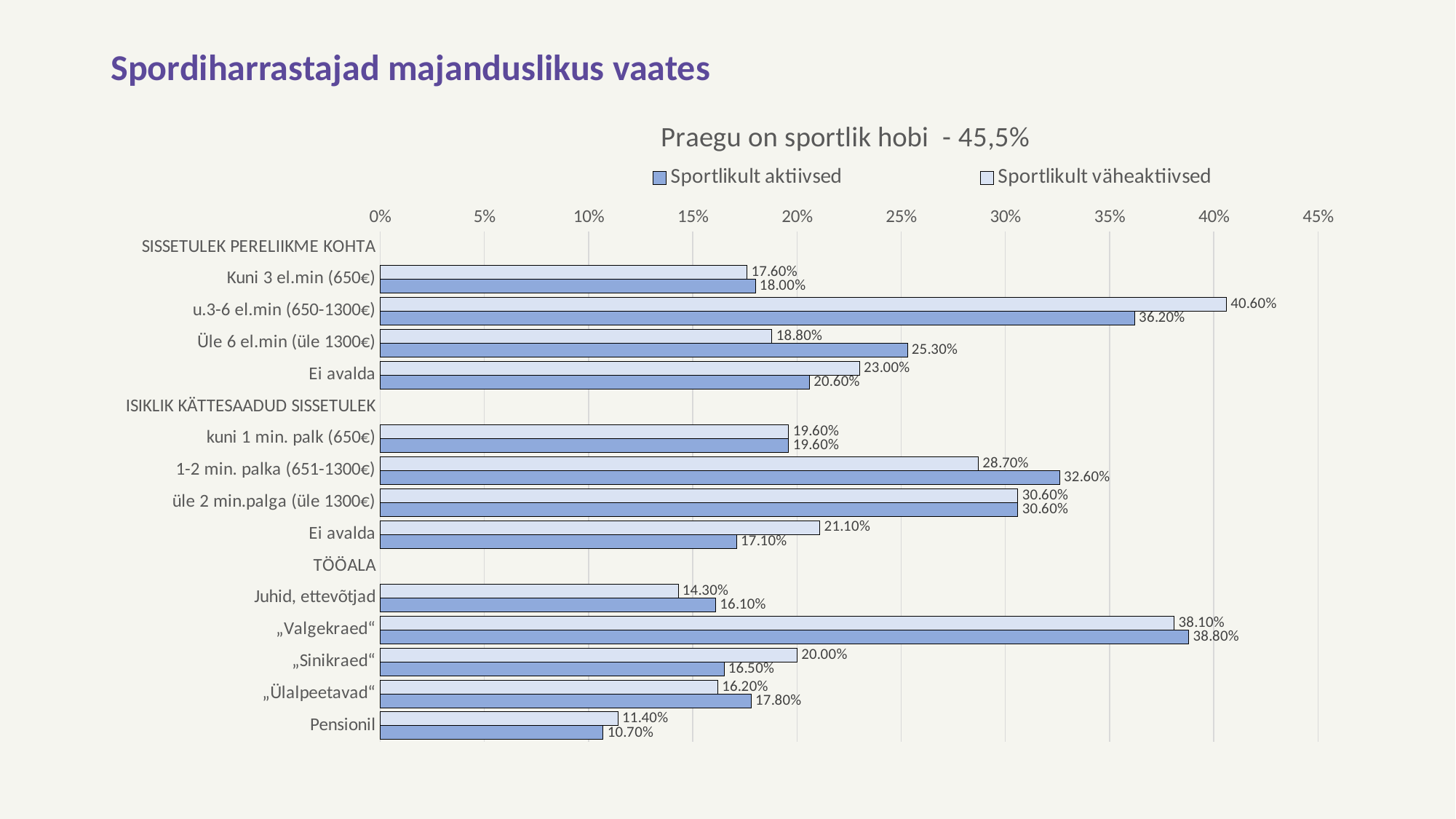
What kind of chart is shown on the slide? bar chart Is the "Sportlikult aktiivsed" value for 1-2 min. palka (651-1300€) greater or less than 30%? greater What is the value for "Sportlikult väheaktiivsed" in the category „Valgekraed“? 38.10% What is the value for "Sportlikult aktiivsed" in the category Pensionil? 10.70% What is the difference between the "Sportlikult aktiivsed" and "Sportlikult väheaktiivsed" values for Üle 6 el.min (üle 1300€)? 6.50% Which category has the lowest value for "Sportlikult aktiivsed"? Pensionil How many series does the legend list? 2 What is the value for "Sportlikult väheaktiivsed" in the "Ei avalda" category under ISIKLIK KÄTTESAADUD SISSETULEK? 21.10% Which category has the highest value for "Sportlikult väheaktiivsed"? u.3-6 el.min (650-1300€) What percentage is stated in the chart title next to "Praegu on sportlik hobi"? 45,5% What is the value for "Sportlikult aktiivsed" in the category u.3-6 el.min (650-1300€)? 36.20% Which is larger for „Sinikraed“: the "Sportlikult aktiivsed" value or the "Sportlikult väheaktiivsed" value? Sportlikult väheaktiivsed